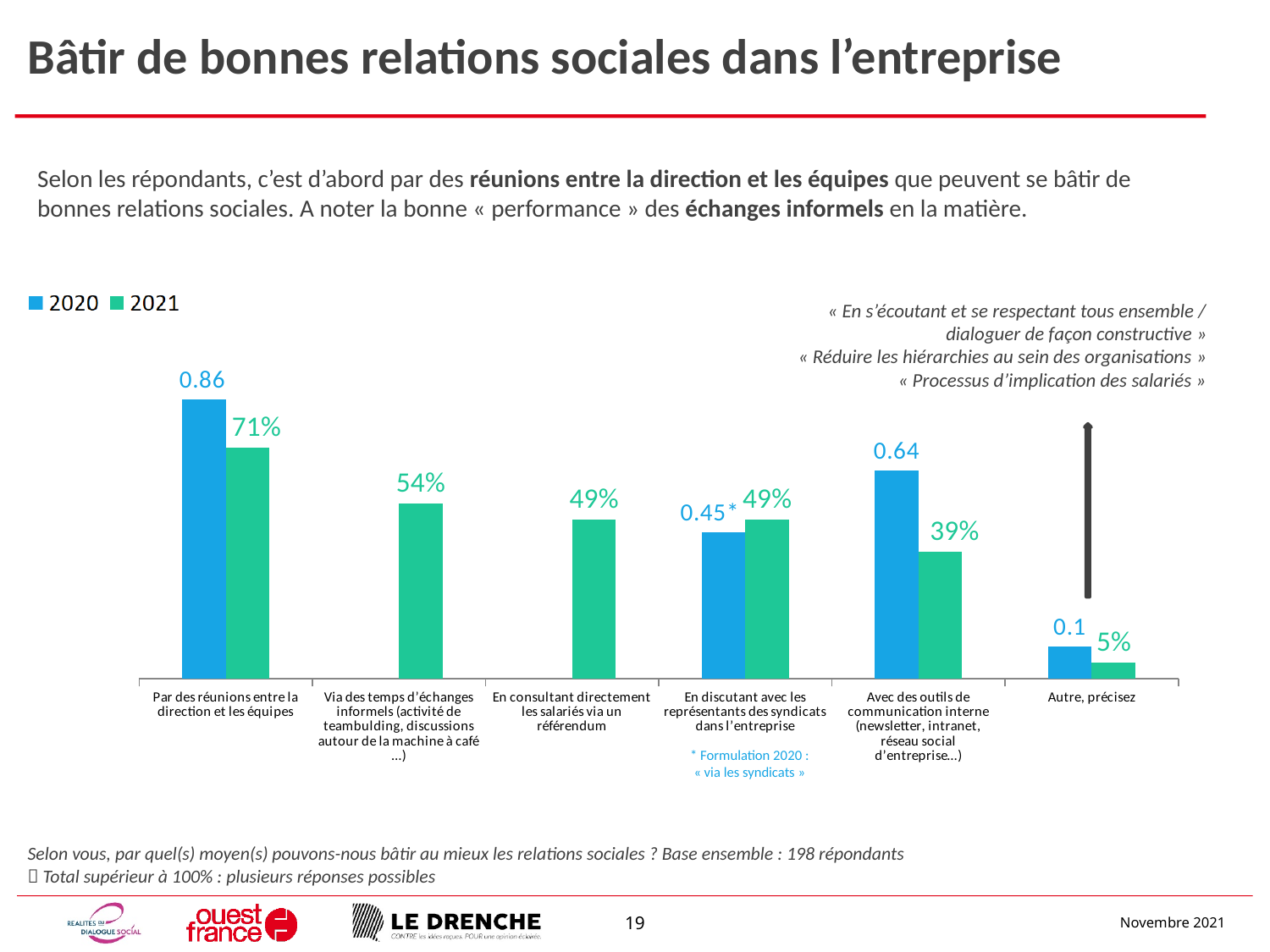
For 2021, which is larger: "Via des temps d'échanges informels" or "Avec des outils de communication interne"? Via des temps d'échanges informels What is the difference between the 2021 values for "Par des réunions entre la direction et les équipes" and "Via des temps d'échanges informels"? 17% What kind of chart is shown on the slide? Bar chart What is the 2020 value for "Avec des outils de communication interne (newsletter, intranet, réseau social d'entreprise…)"? 0.64 What is the 2021 value for "Par des réunions entre la direction et les équipes"? 71% What is the 2020 value for "Autre, précisez"? 0.1 Which category has the highest 2021 value? Par des réunions entre la direction et les équipes What is the difference between the 2020 values for "Par des réunions entre la direction et les équipes" and "Avec des outils de communication interne"? 0.22 How many categories are shown on the x axis of the chart? 6 How many series does the legend list? 2 What is the 2021 value for "Via des temps d'échanges informels"? 54% Which category has the lowest 2021 value? Autre, précisez